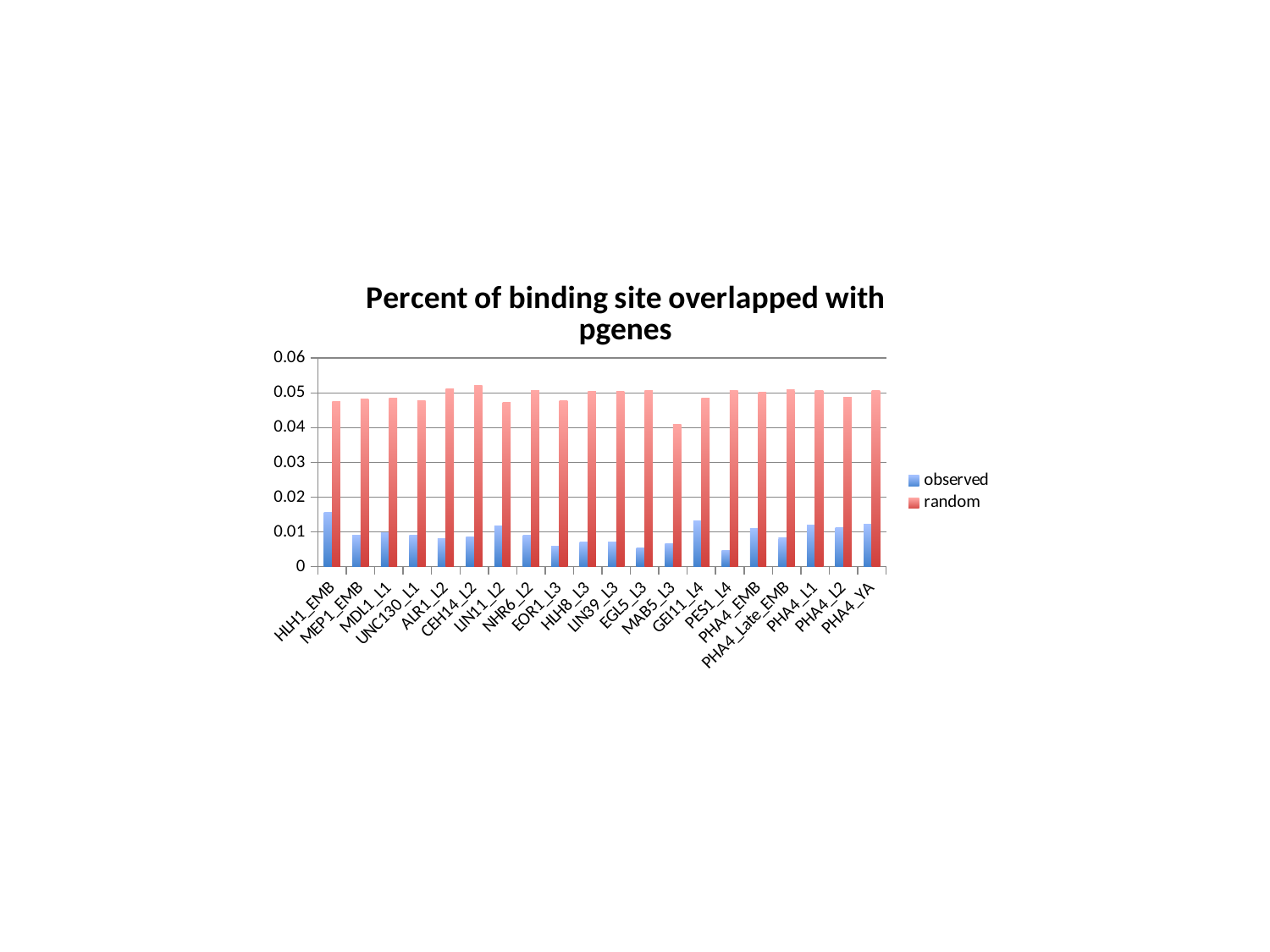
Which is larger: the observed value for HLH1_EMB or the observed value for MAB5_L3? HLH1_EMB How many categories are shown on the x axis? 20 For MDL1_L1, which is larger: the observed value or the random value? random Which category has the lowest random value? MAB5_L3 Is the random value for CEH14_L2 greater or less than 0.05? greater How many series does the legend list? 2 Is the observed value for HLH1_EMB greater or less than 0.01? greater Is the observed value for PES1_L4 greater or less than 0.01? less What kind of chart is shown on the slide? bar chart What is the title of the chart? Percent of binding site overlapped with pgenes Which category has the highest observed value? HLH1_EMB